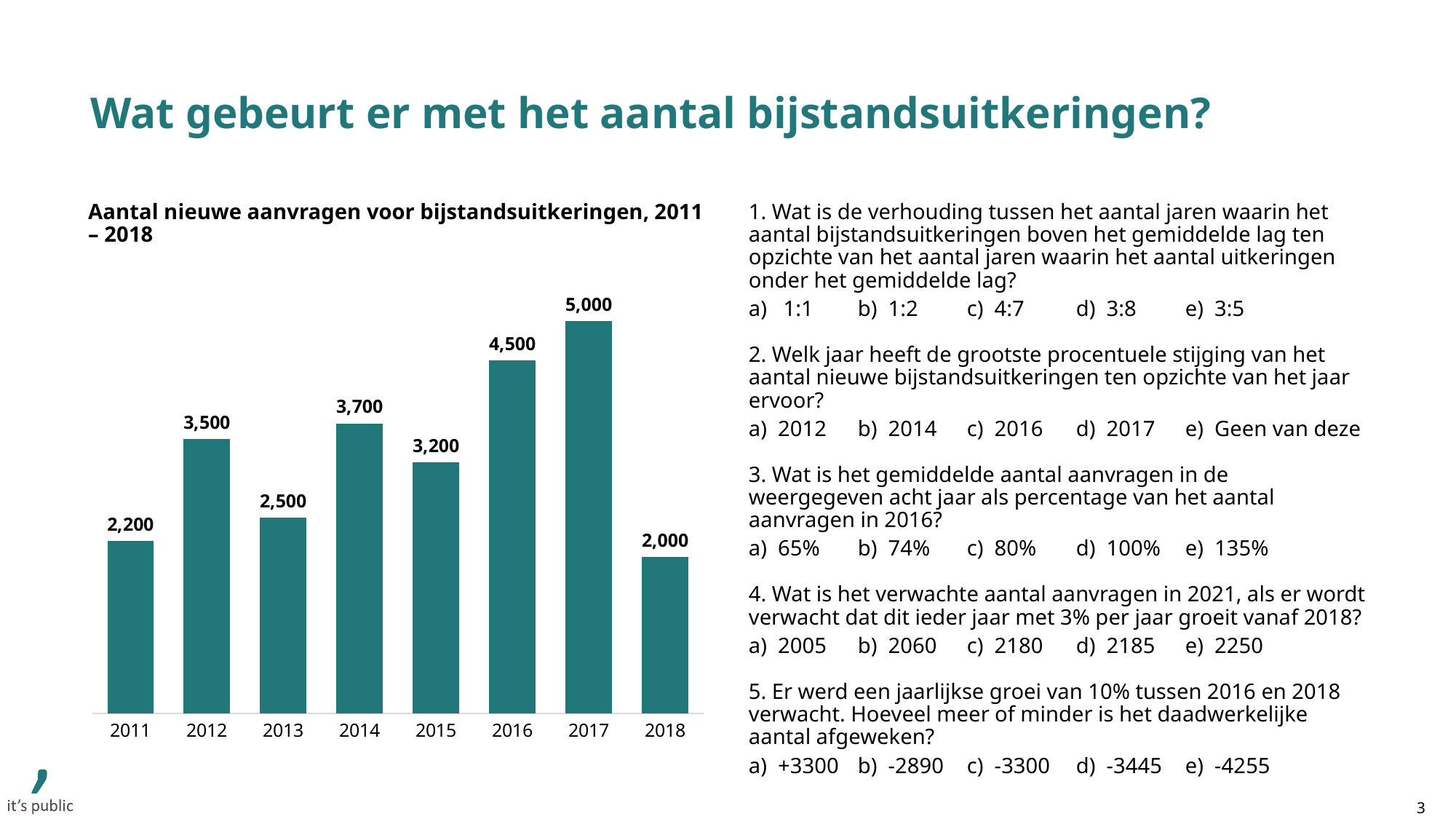
What kind of chart is shown on the slide? bar chart Do the values rise or fall from 2017 to 2018? fall Which year has the highest number of new applications? 2017 Do the values rise or fall from 2013 to 2014? rise Which year has the lowest number of new applications? 2018 Which is larger, the value for 2015 or the value for 2012? 2012 What is the difference between the values for 2012 and 2013? 1,000 How many years are shown on the x axis? 8 What is the title of the chart? Aantal nieuwe aanvragen voor bijstandsuitkeringen, 2011 – 2018 What is the difference between the values for 2017 and 2016? 500 What is the value for 2018? 2,000 What is the value for 2014? 3,700